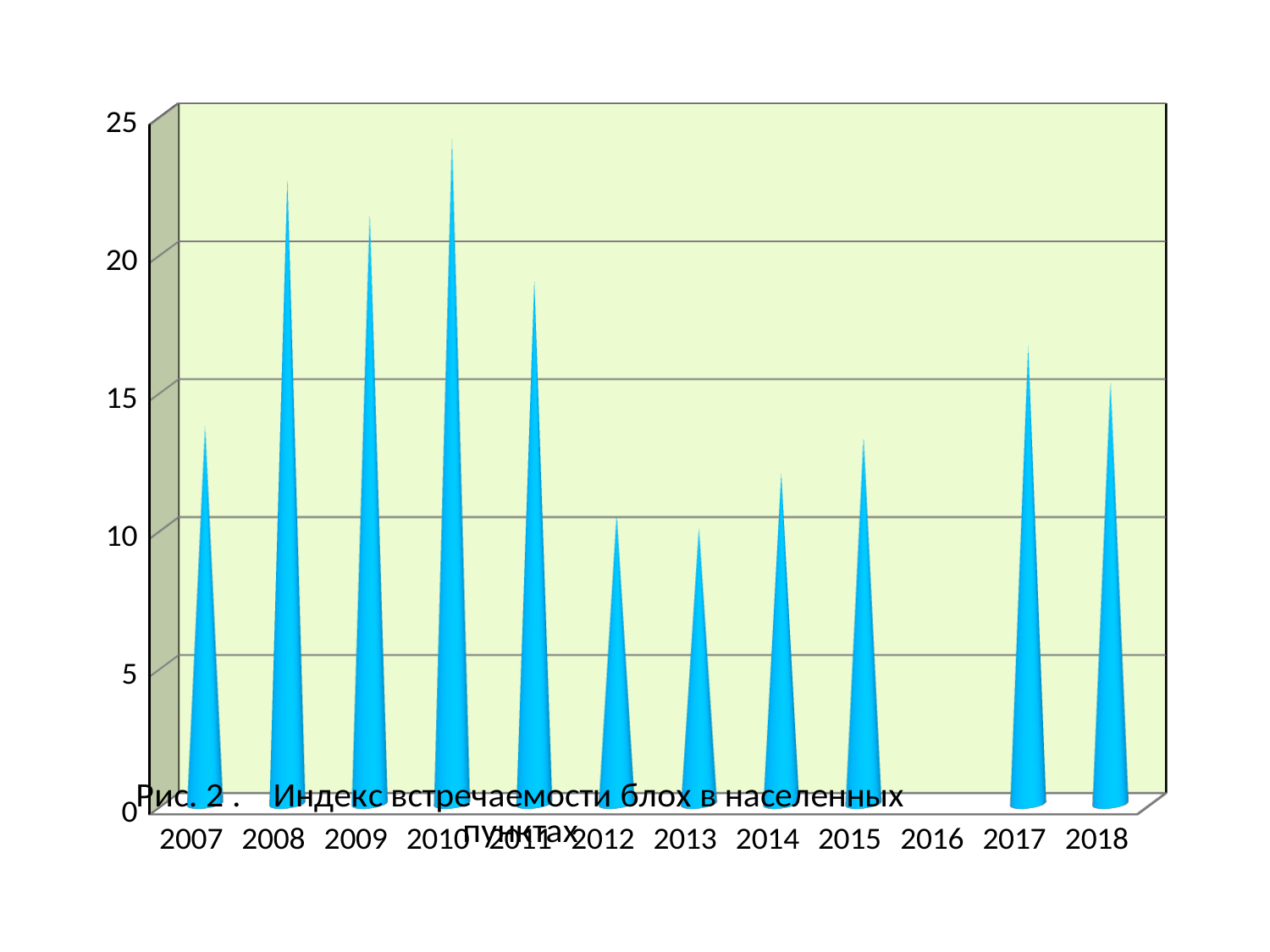
Which year has the highest value in the chart? 2010 Is the value for 2015 greater or less than 15? less Is the value for 2017 greater or less than 15? greater Is the value for 2008 greater or less than 20? greater Which year has the larger value, 2008 or 2007? 2008 How many years are labelled on the x axis of the chart? 12 Which year has the larger value, 2011 or 2014? 2011 Do the values rise or fall from 2010 to 2013? fall What kind of chart is shown on the slide? bar chart What is the caption of the chart on the slide? Рис. 2 . Индекс встречаемости блох в населенных пунктах